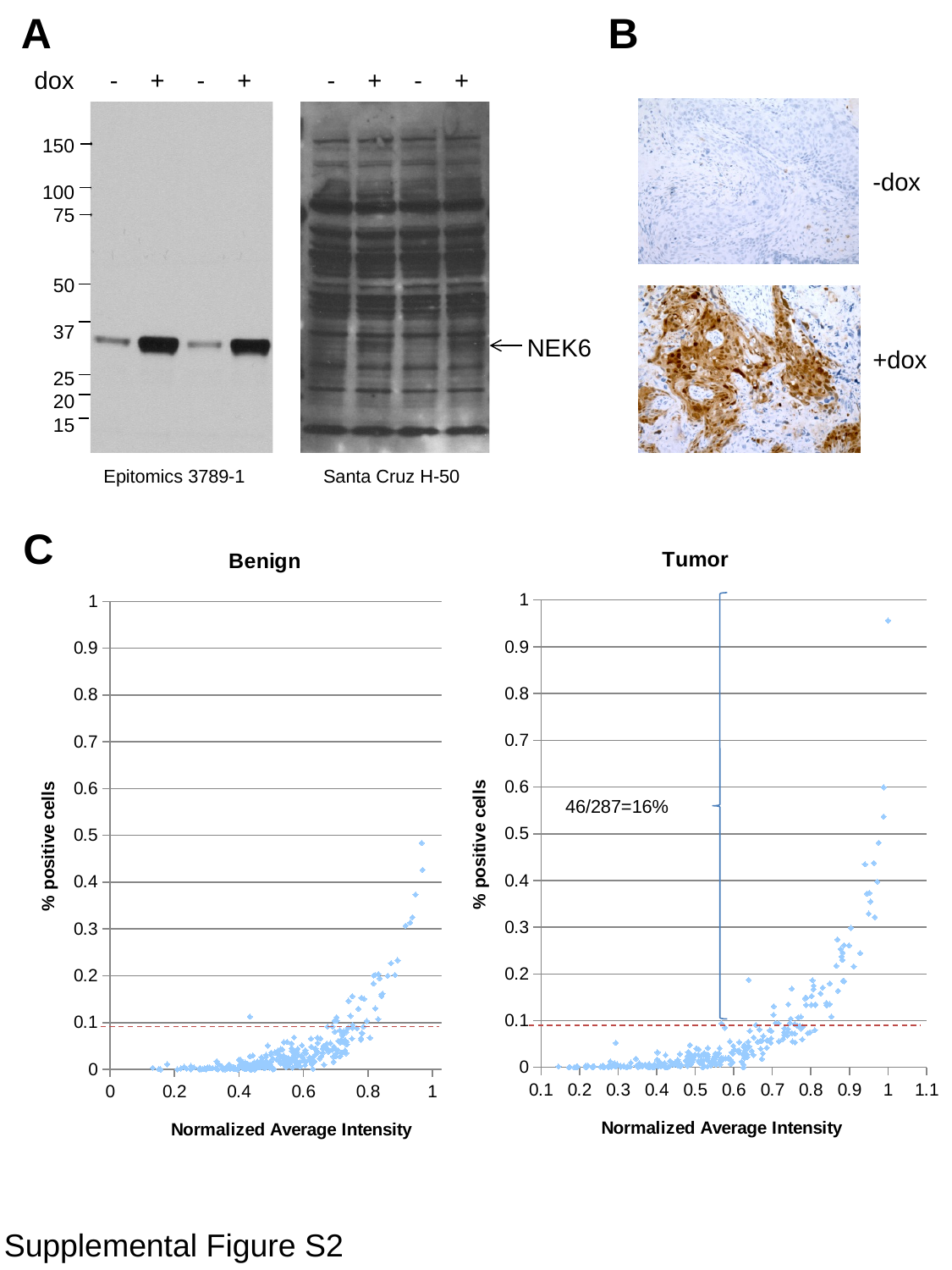
In the Benign chart, is the highest plotted % positive cells value greater or less than 0.6? less In the Benign chart, do the % positive cells values generally rise or fall as Normalized Average Intensity increases? rise In the Tumor chart, is the highest plotted % positive cells value greater or less than 0.9? greater In the Tumor chart, do the % positive cells values generally rise or fall as Normalized Average Intensity increases? rise What is the y-axis title of the Tumor chart? % positive cells What kind of chart is the Benign chart in panel C? scatter chart What kind of chart is the Tumor chart in panel C? scatter chart Which chart in panel C has the higher maximum % positive cells value, Benign or Tumor? Tumor In the Benign chart, is the highest plotted % positive cells value greater or less than 0.4? greater In the Tumor chart, what fraction and percentage are printed in the annotation? 46/287=16% What is the x-axis title of the Benign chart? Normalized Average Intensity How many charts are shown in panel C? 2